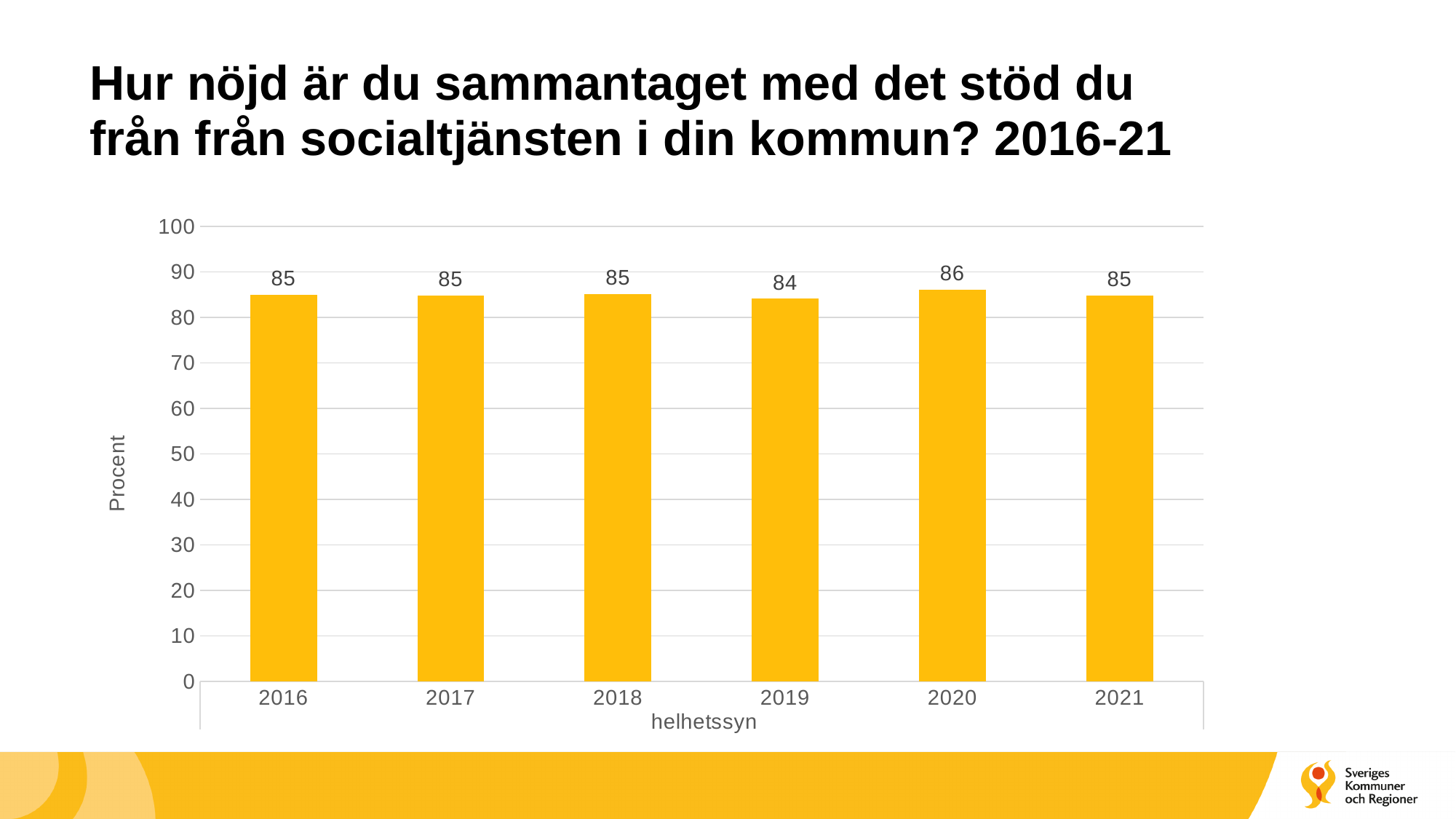
What is the label of the vertical axis? Procent Which year has the highest value? 2020 What is the value for 2019? 84 Which year has the lowest value? 2019 What is the value for 2021? 85 What is the value for 2020? 86 Which is larger, the value for 2020 or the value for 2019? 2020 What is the difference between the values for 2020 and 2019? 2 How many years are shown on the x axis? 6 What is the value for 2016? 85 What kind of chart is shown on the slide? bar chart Is the value for 2018 greater or less than 80? greater